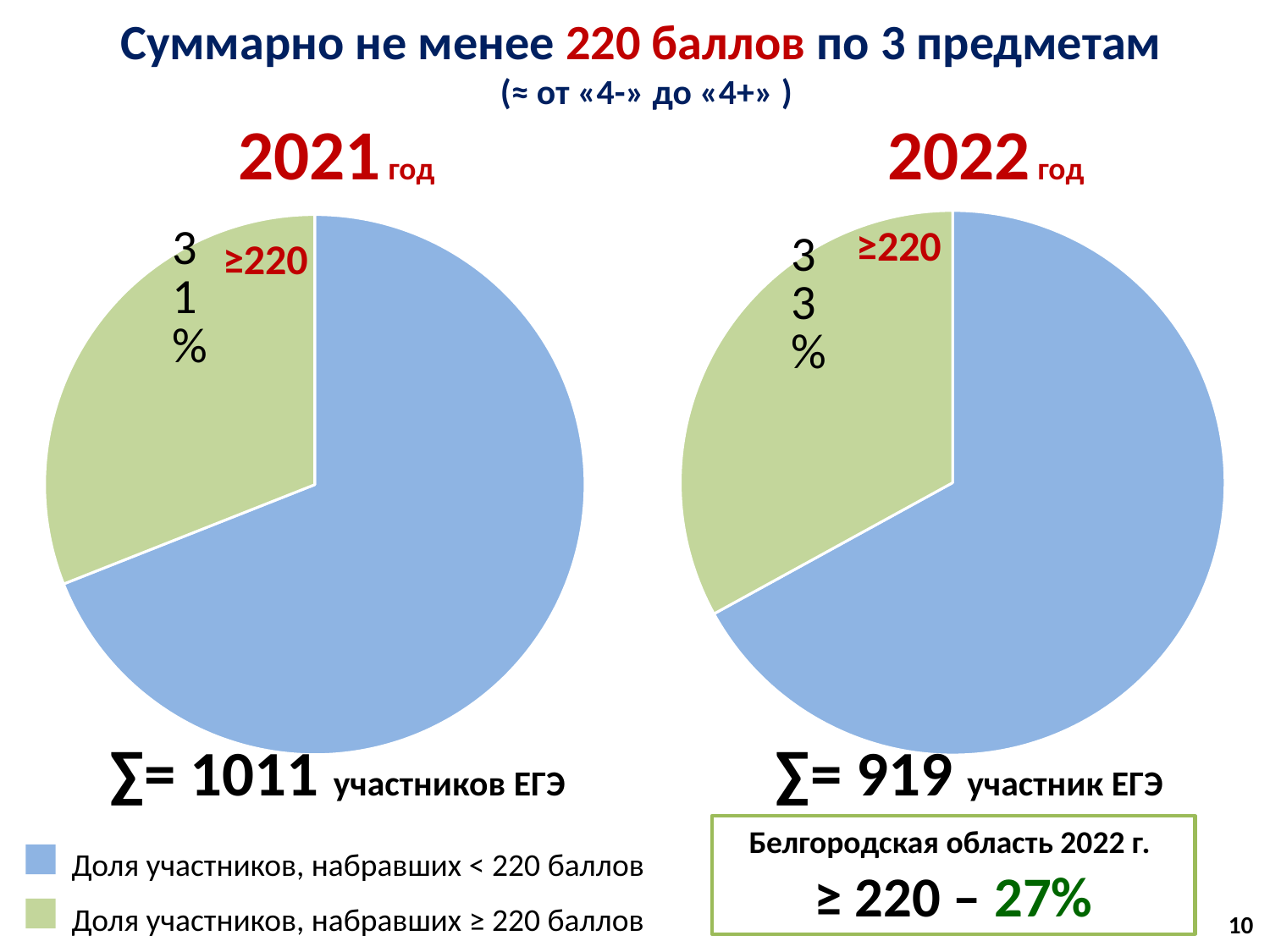
How many ЕГЭ participants are represented in the 2021 pie chart? 1011 In the 2022 pie chart, what share of participants scored ≥220 points? 33% What kind of chart is used for the 2021 and 2022 data on this slide? Pie chart In the 2021 pie chart, what share of participants scored ≥220 points? 31% How many slices does the 2022 pie chart have? 2 How many pie charts are shown on the slide? 2 How many ЕГЭ participants are represented in the 2022 pie chart? 919 Which year's pie chart shows the larger share of participants with ≥220 points, 2021 or 2022? 2022 How many entries does the legend list? 2 By how many percentage points did the share of participants with ≥220 points change from 2021 to 2022? 2% In the 2021 pie chart, which slice is larger: participants with < 220 points or participants with ≥ 220 points? Participants with < 220 points Which colour represents the share of participants who scored ≥ 220 points? Green